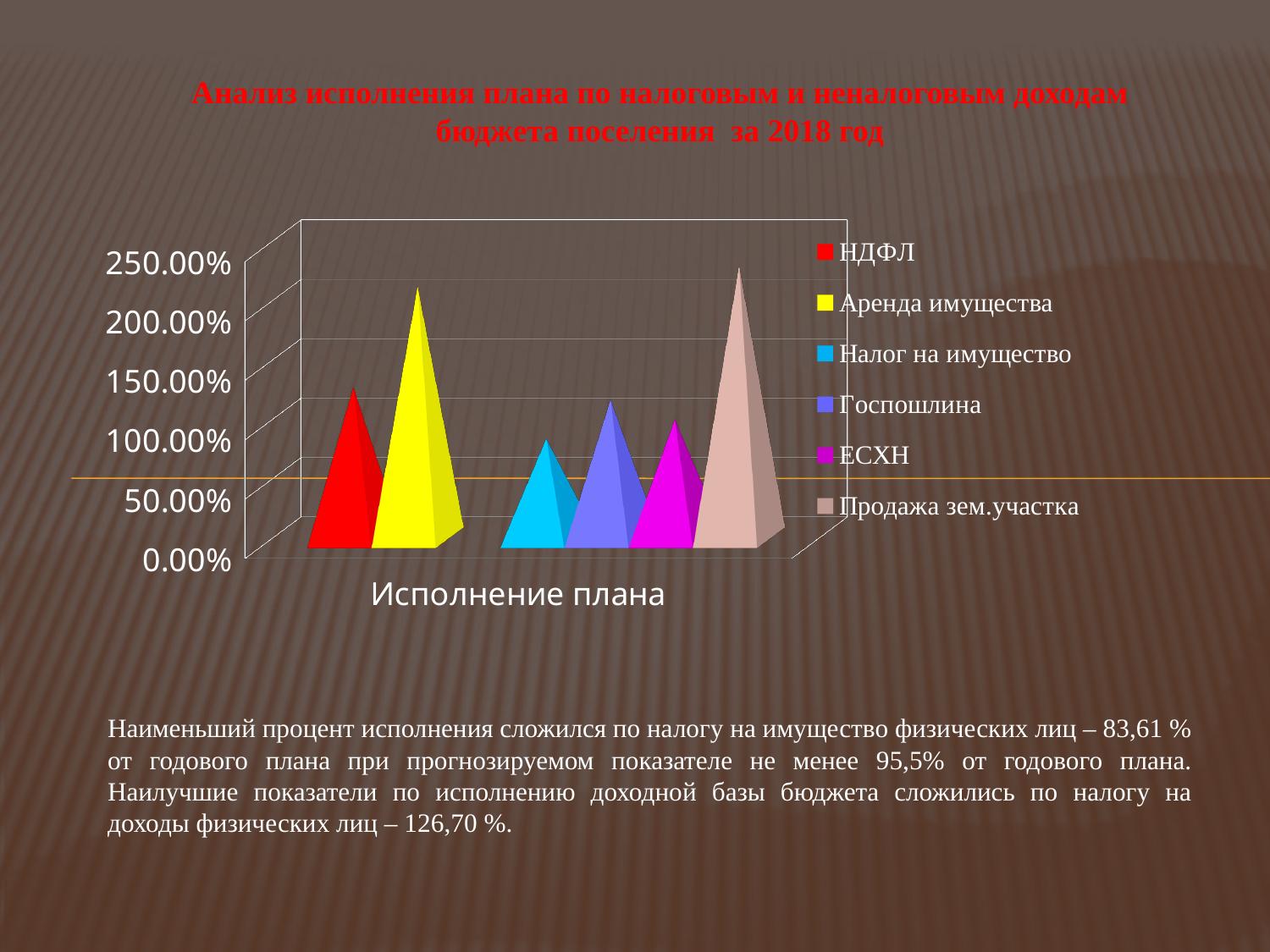
Which is larger, the value for Госпошлина or the value for Налог на имущество? Госпошлина Is the value for Госпошлина greater or less than 200.00%? less What is the category label shown on the x axis? Исполнение плана Which series has the lowest value? Налог на имущество How many series does the legend list? 6 How many categories are shown on the x axis? 1 Which series has the highest value? Продажа зем.участка Which is larger, the value for Аренда имущества or the value for НДФЛ? Аренда имущества What kind of chart is shown on the slide? bar chart Is the value for Налог на имущество greater or less than 150.00%? less Is the value for Аренда имущества greater or less than 200.00%? greater What colour represents НДФЛ in the legend? red